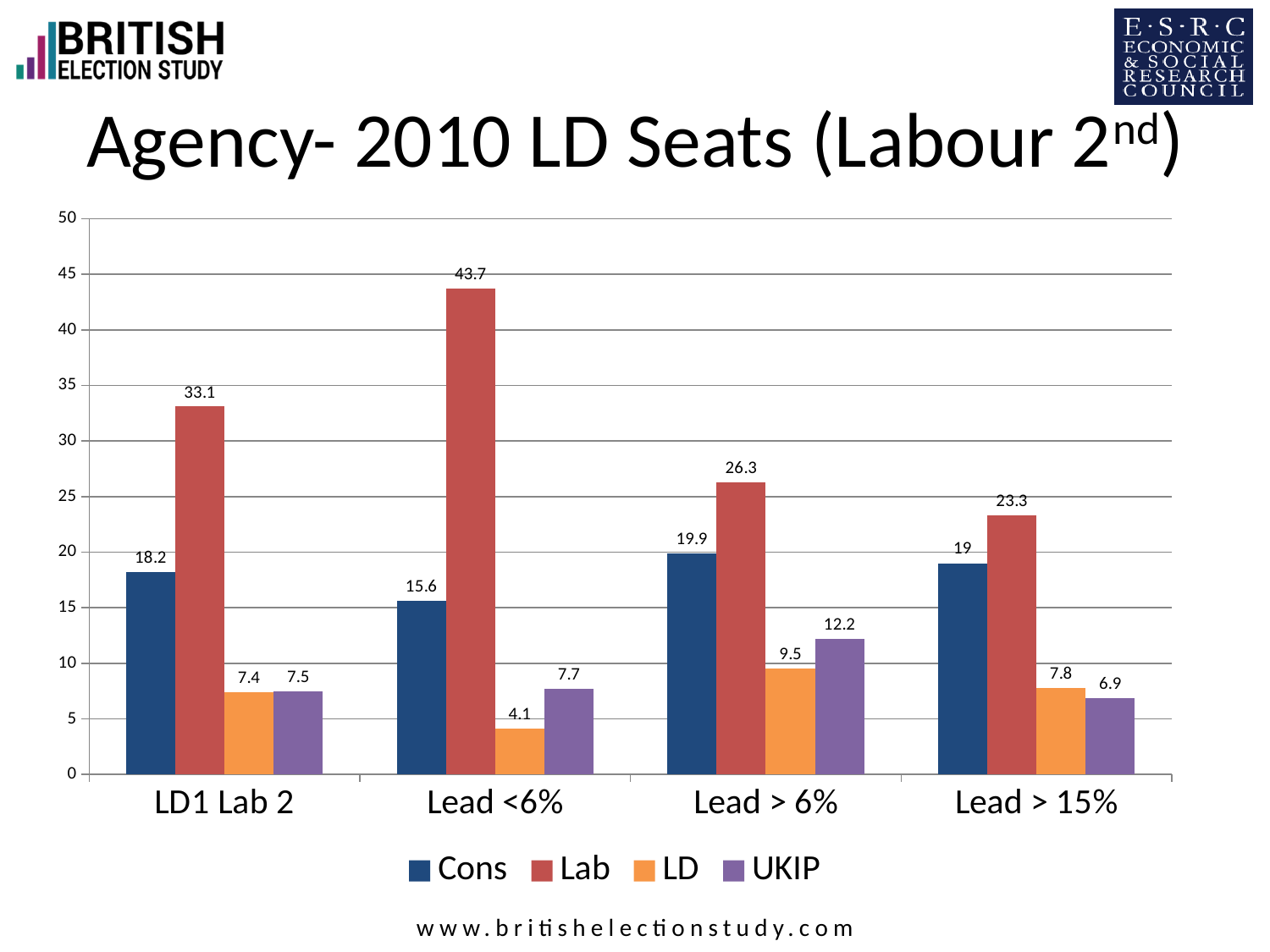
What is the difference between the Lab and Cons values in the LD1 Lab 2 category? 14.9 What is the value for Cons in the LD1 Lab 2 category? 18.2 Which is larger in the Lead > 15% category, the LD value or the UKIP value? LD What is the title of the slide? Agency- 2010 LD Seats (Labour 2nd) In which category is the Lab value highest? Lead <6% What is the value for LD in the Lead > 15% category? 7.8 In which category is the LD value lowest? Lead <6% How many categories are shown on the x axis? 4 What kind of chart is shown on the slide? Bar chart What is the value for Lab in the Lead <6% category? 43.7 How many series does the legend list? 4 What is the value for UKIP in the Lead > 6% category? 12.2